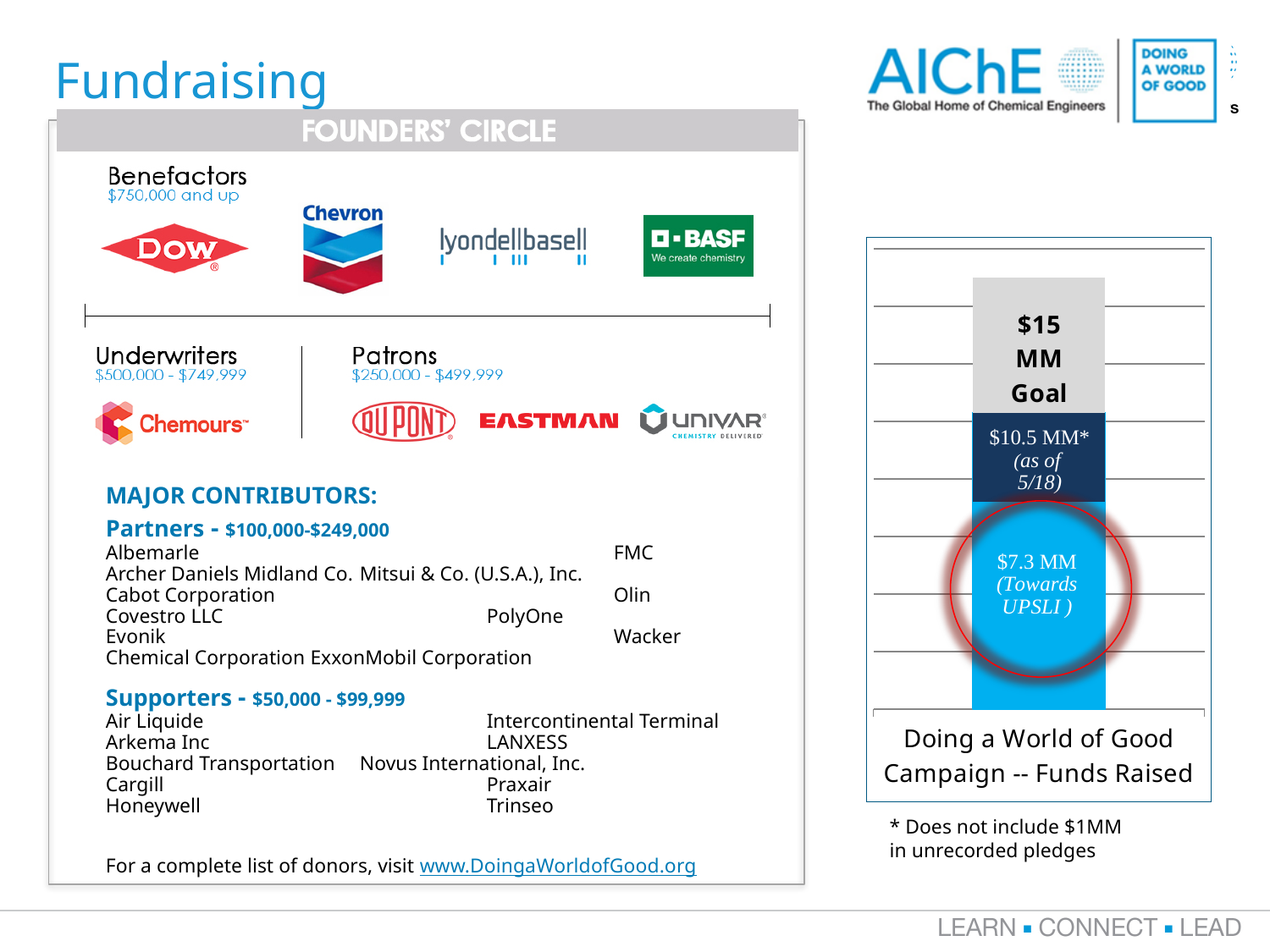
In the 'Doing a World of Good Campaign -- Funds Raised' chart, how much is labelled as going towards UPSLI? $7.3 MM What is the title of the chart on the right side of the slide? Doing a World of Good Campaign -- Funds Raised In the 'Doing a World of Good Campaign -- Funds Raised' chart, as of what date is the $10.5 MM figure reported? 5/18 In the 'Doing a World of Good Campaign -- Funds Raised' chart, how much had been raised as of 5/18? $10.5 MM In the 'Doing a World of Good Campaign -- Funds Raised' chart, what is the difference between the $10.5 MM raised and the $7.3 MM towards UPSLI? $3.2 MM In the 'Doing a World of Good Campaign -- Funds Raised' chart, which is larger: the goal or the amount raised as of 5/18? the goal How many labelled segments make up the bar in the 'Doing a World of Good Campaign -- Funds Raised' chart? 3 In the 'Doing a World of Good Campaign -- Funds Raised' chart, how much more is the $15 MM goal than the $10.5 MM raised as of 5/18? $4.5 MM What kind of chart is the 'Doing a World of Good Campaign -- Funds Raised' chart? bar chart In the 'Doing a World of Good Campaign -- Funds Raised' chart, what is the campaign goal shown at the top of the bar? $15 MM According to the footnote below the 'Doing a World of Good Campaign -- Funds Raised' chart, how much in unrecorded pledges is not included in the $10.5 MM figure? $1MM